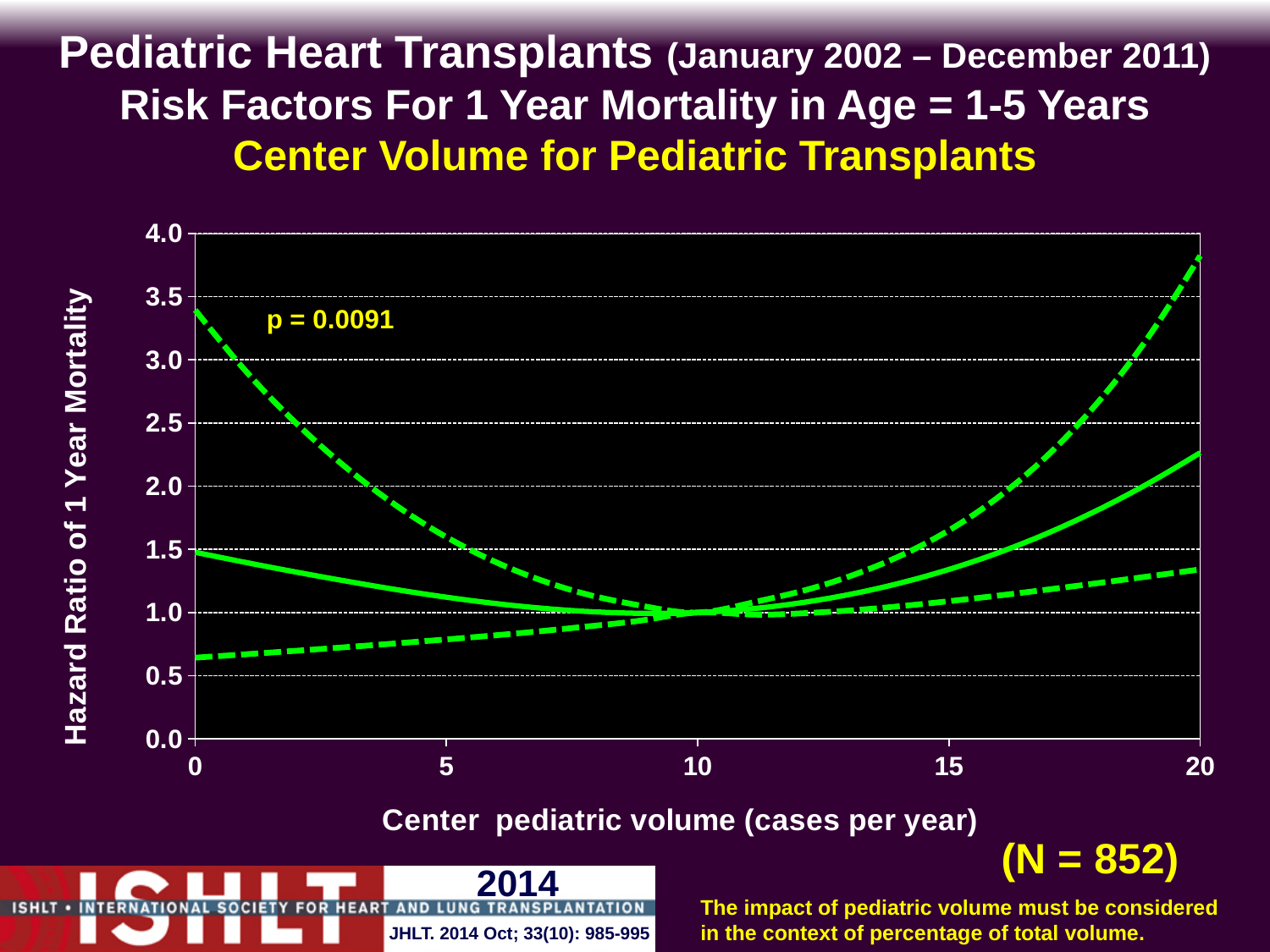
Is the value of the upper dashed line at a center pediatric volume of 20 cases per year greater or less than 3.5? greater Is the value of the solid line at a center pediatric volume of 20 cases per year greater or less than 2.0? greater Does the solid line rise or fall as center pediatric volume increases from 10 to 20 cases per year? rise How many lines are plotted on the chart? 3 What is the highest value shown on the x axis? 20 Is the value of the lower dashed line at a center pediatric volume of 0 cases per year greater or less than 1.0? less Does the upper dashed line rise or fall as center pediatric volume increases from 0 to 10 cases per year? fall What is the p-value printed on the chart? p = 0.0091 What kind of chart is shown on the slide? line chart What is the title of the y axis? Hazard Ratio of 1 Year Mortality